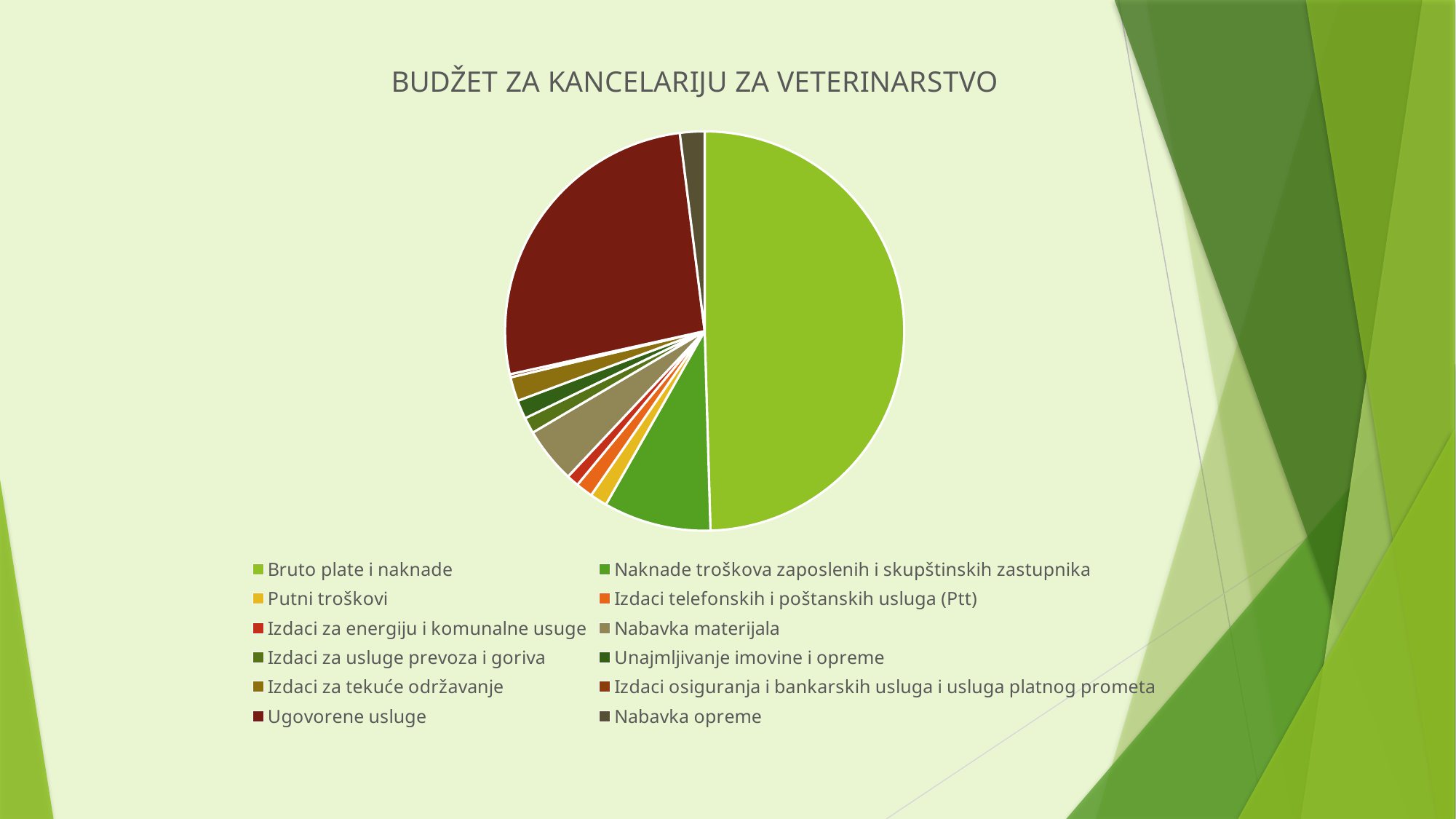
Which category is shown in dark red in the pie chart? Ugovorene usluge What kind of chart is shown on the slide? pie chart How many categories does the pie chart have? 12 Which category has the largest slice of the pie? Bruto plate i naknade What is the title of the chart? BUDŽET ZA KANCELARIJU ZA VETERINARSTVO Which slice is larger, Naknade troškova zaposlenih i skupštinskih zastupnika or Nabavka opreme? Naknade troškova zaposlenih i skupštinskih zastupnika Which slice is larger, Nabavka materijala or Putni troškovi? Nabavka materijala Which slice is larger, Ugovorene usluge or Naknade troškova zaposlenih i skupštinskih zastupnika? Ugovorene usluge